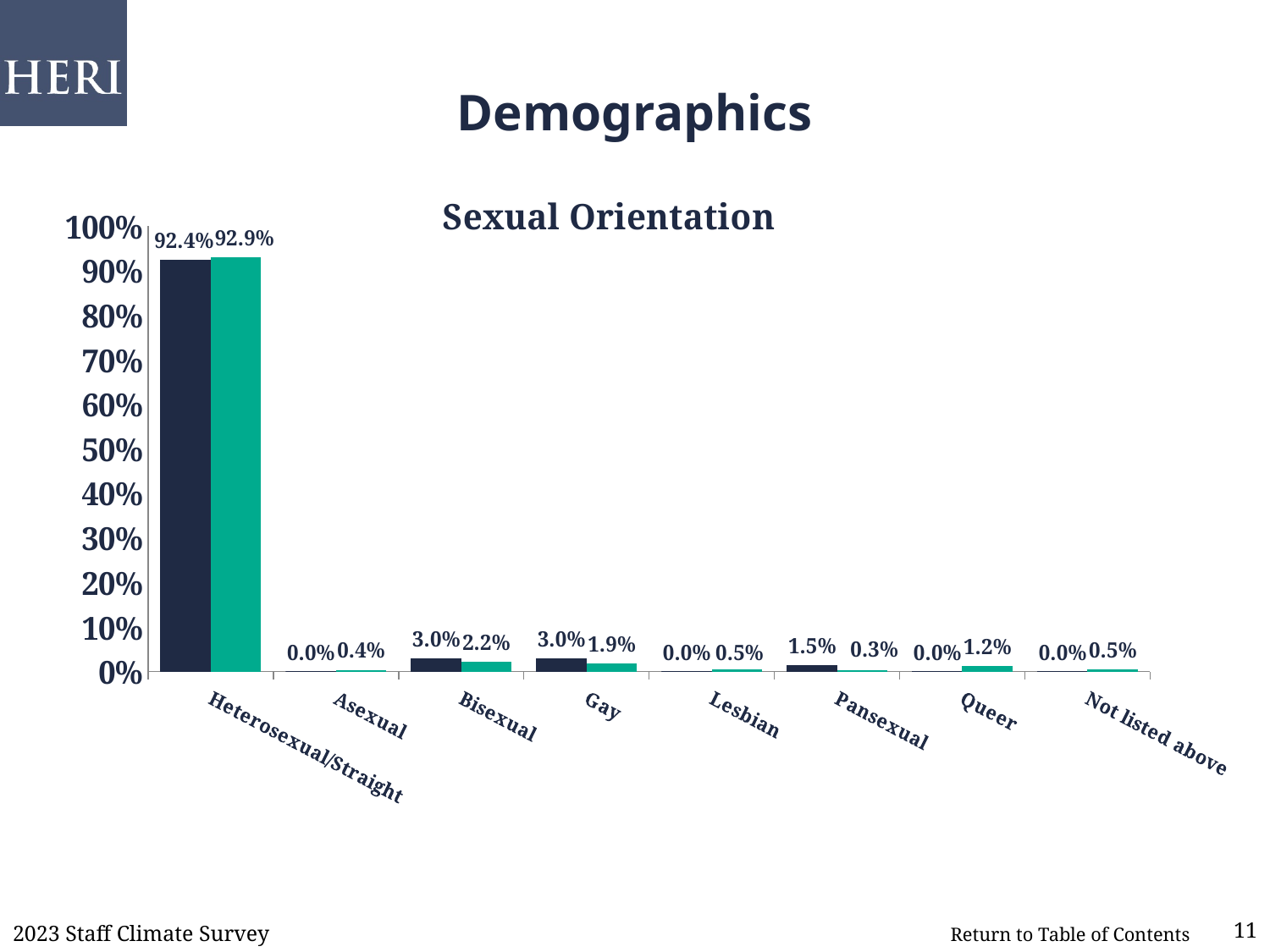
How many categories are shown on the x axis? 8 What is the title of the chart? Sexual Orientation What is the value of the dark navy bar for Heterosexual/Straight? 92.4% What is the value of the teal bar for Queer? 1.2% What is the difference between the dark navy and teal bars for Gay? 1.1% What is the value of the teal bar for Heterosexual/Straight? 92.9% What kind of chart is shown on the slide? bar chart Which is larger for Pansexual, the dark navy bar or the teal bar? the dark navy bar Which category has the highest value for the dark navy bars? Heterosexual/Straight What is the value of the teal bar for Bisexual? 2.2% What is the value of the dark navy bar for Pansexual? 1.5% What is the difference between the teal and dark navy bars for Heterosexual/Straight? 0.5%